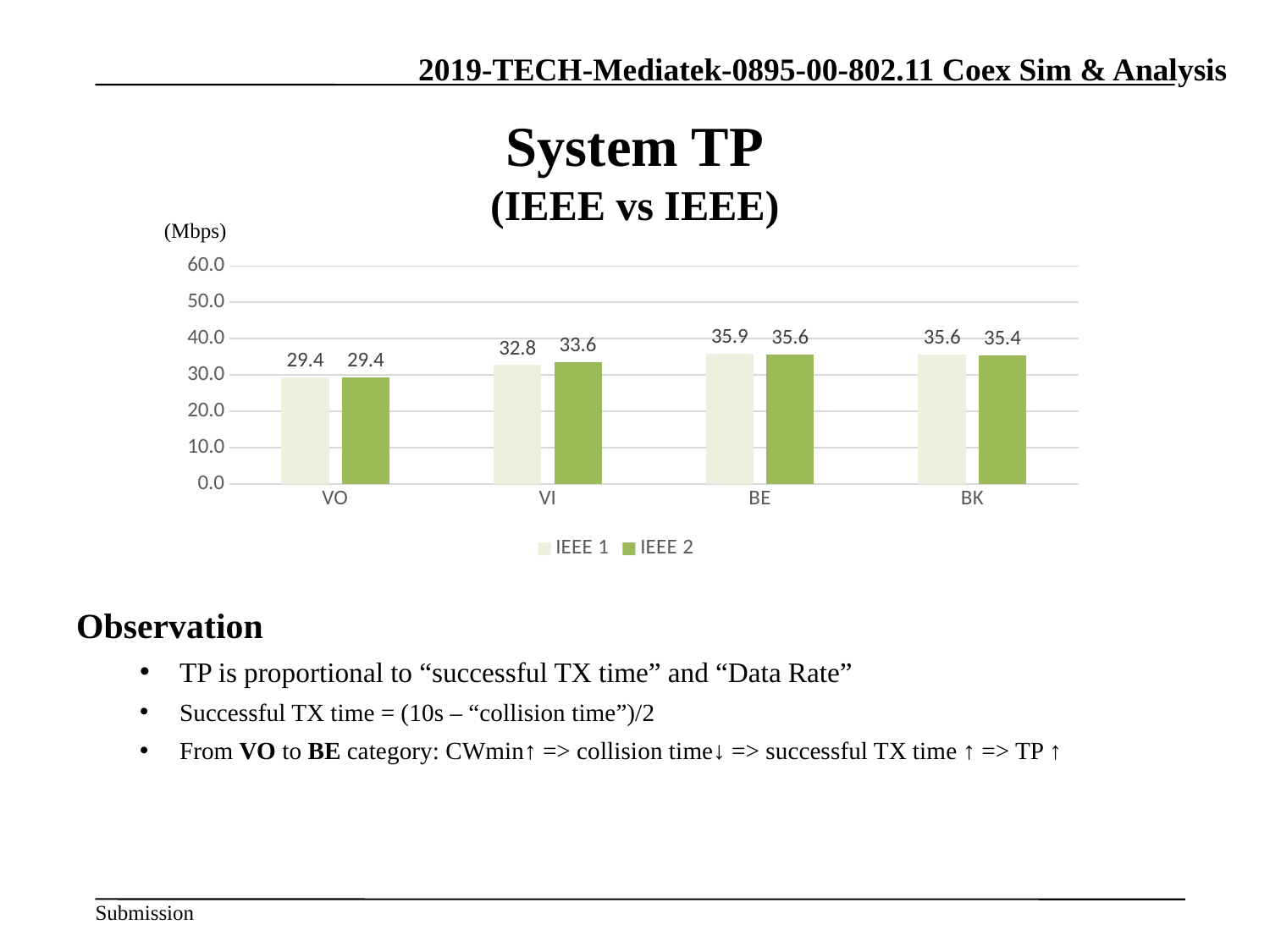
What is the difference between the IEEE 2 and IEEE 1 values for VI? 0.8 How many categories are shown on the x axis? 4 Is the IEEE 1 value for VO greater or less than 30.0? less Which is larger for BE, the IEEE 1 value or the IEEE 2 value? IEEE 1 Which category has the highest IEEE 1 value? BE What is the IEEE 2 value for VO? 29.4 How many series does the legend list? 2 What is the IEEE 1 value for VI? 32.8 What kind of chart is shown? bar chart What is the IEEE 2 value for BK? 35.4 What unit is shown for the y axis of the chart? Mbps Which category has the lowest IEEE 2 value? VO